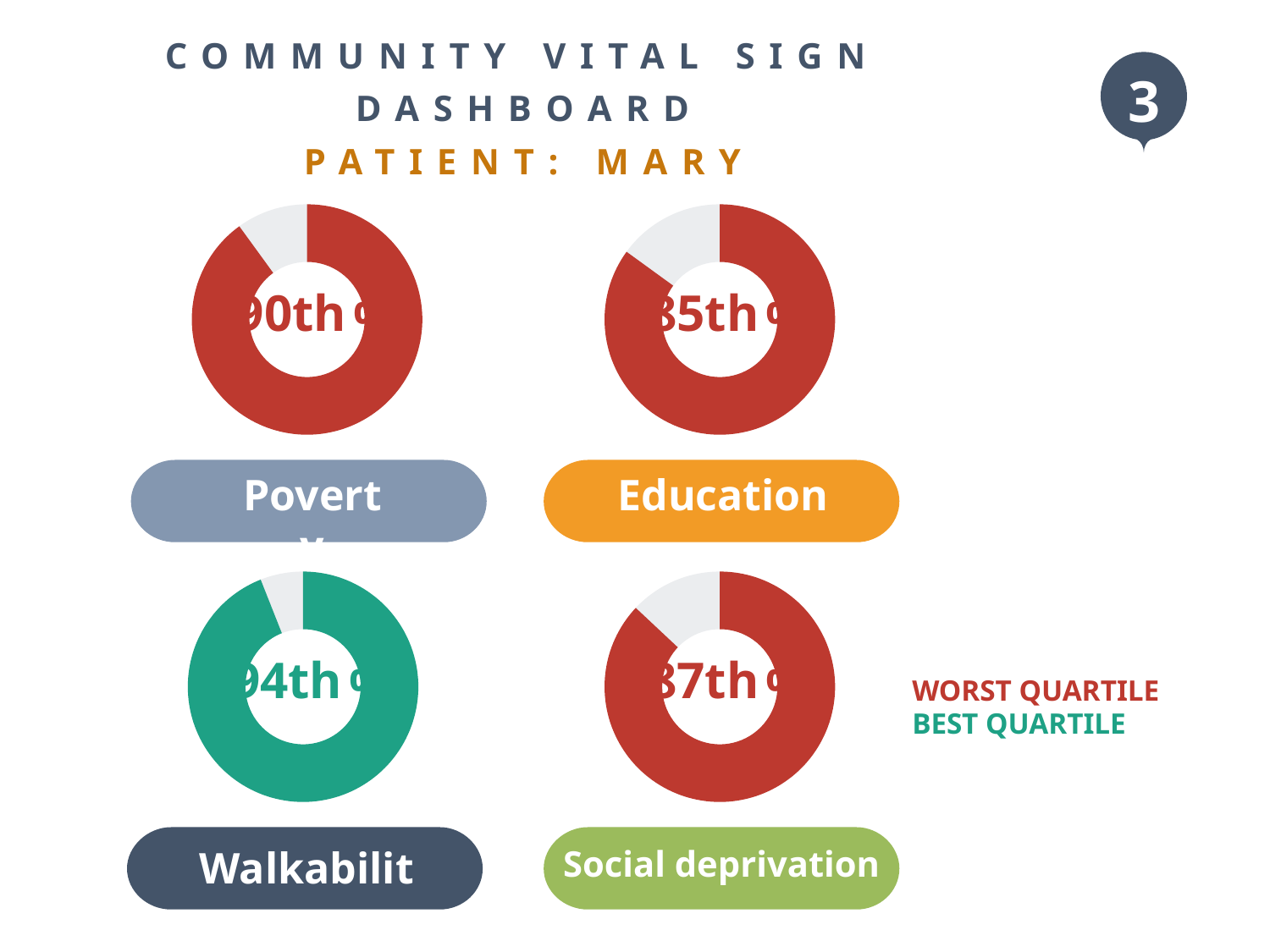
In the Social deprivation chart, what percentile value is printed in the centre? 87th What kind of charts are shown on the slide? Donut charts In the Walkability chart, what percentile value is printed in the centre? 94th In the Poverty chart, what percentile value is printed in the centre? 90th Across the four donut charts, which measure shows the highest percentile? Walkability Which has the larger percentile value, the Walkability chart or the Education chart? Walkability Which of the four donut charts is coloured green (best quartile)? Walkability Across the four donut charts, which measure shows the lowest percentile? Education How many donut charts are on the slide? 4 According to the key on the slide, what does the red colour of the donut rings indicate? Worst quartile In the Education chart, what percentile value is printed in the centre? 85th Which has the larger percentile value, the Poverty chart or the Social deprivation chart? Poverty